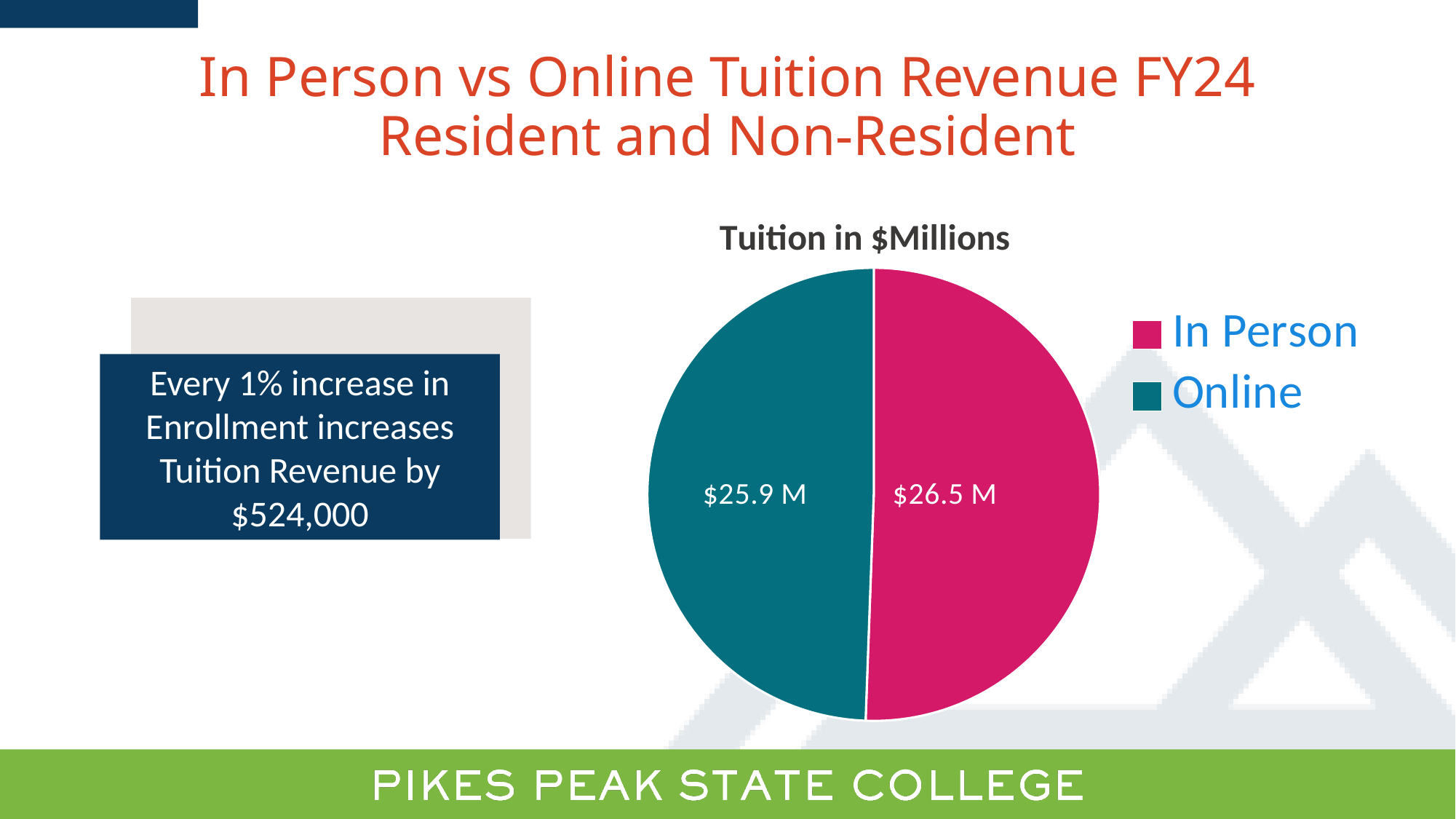
What kind of chart is shown on the slide? pie chart What is the difference between the In Person and Online values in the pie chart? $0.6 M What is the value of the Online slice in the pie chart? $25.9 M How many entries does the legend of the pie chart list? 2 Which category has the smaller tuition revenue in the pie chart? Online Is the In Person value larger or smaller than the Online value? larger Which colour represents Online in the pie chart? teal What is the combined total of the two slices in the pie chart? $52.4 M What is the value of the In Person slice in the pie chart? $26.5 M Which category has the larger tuition revenue in the pie chart? In Person How many slices does the pie chart have? 2 What is the title of the pie chart? Tuition in $Millions